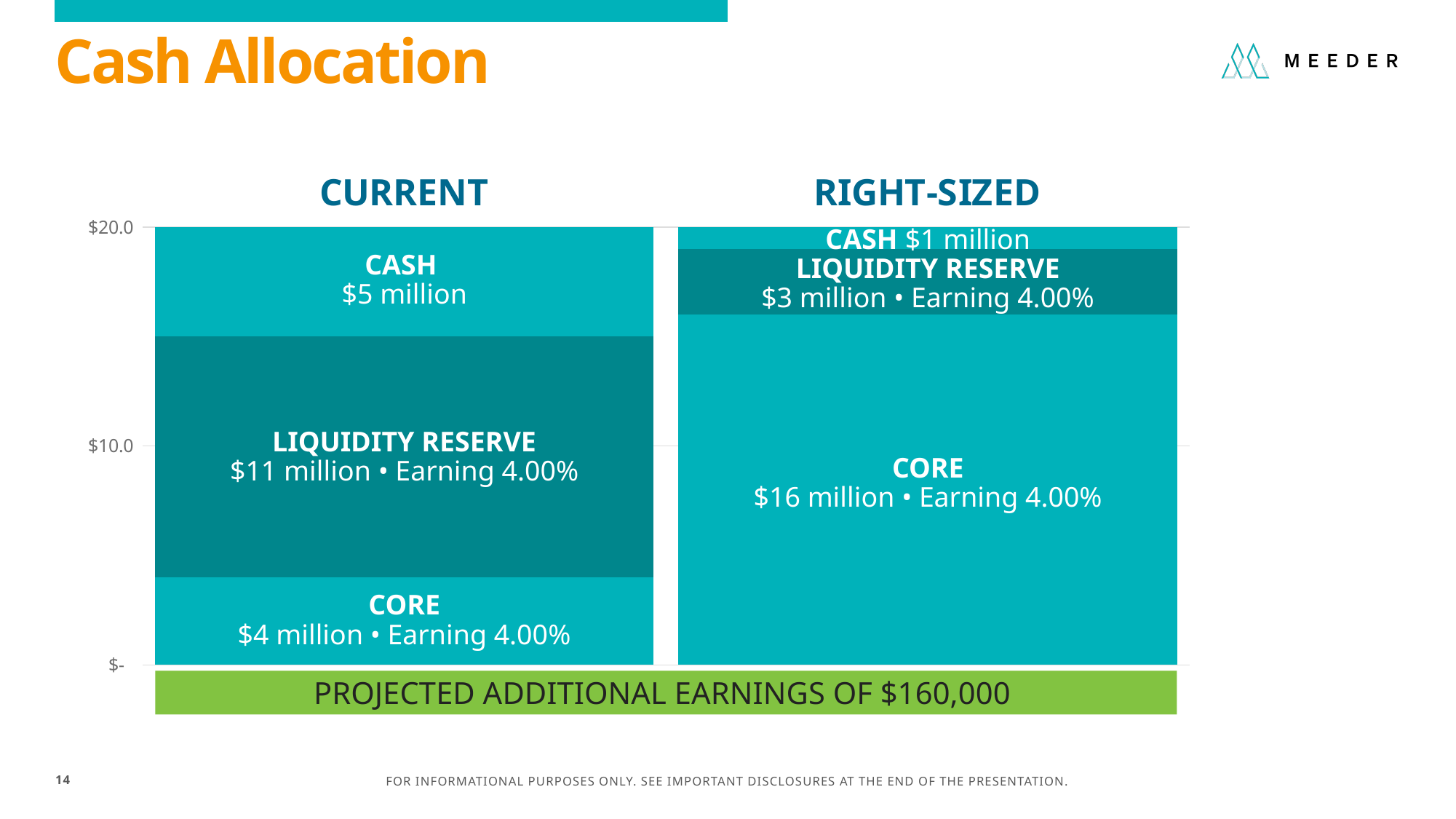
What is the difference between the Core amount in the Right-Sized allocation and the Core amount in the Current allocation? $12 million What is the Core amount in the Right-Sized allocation? $16 million What is the Cash amount in the Right-Sized allocation? $1 million What is the total of the Current stacked bar? $20 million What projected additional earnings figure is shown below the chart? $160,000 Which segment is the largest in the Current bar? Liquidity Reserve How many bars are shown in the chart? 2 What is the Cash amount in the Current allocation? $5 million Which segment is the smallest in the Right-Sized bar? Cash Which is larger: the Liquidity Reserve in the Current allocation or the Liquidity Reserve in the Right-Sized allocation? Current What kind of chart is shown on the slide? Stacked bar chart What is the Liquidity Reserve amount in the Current allocation? $11 million